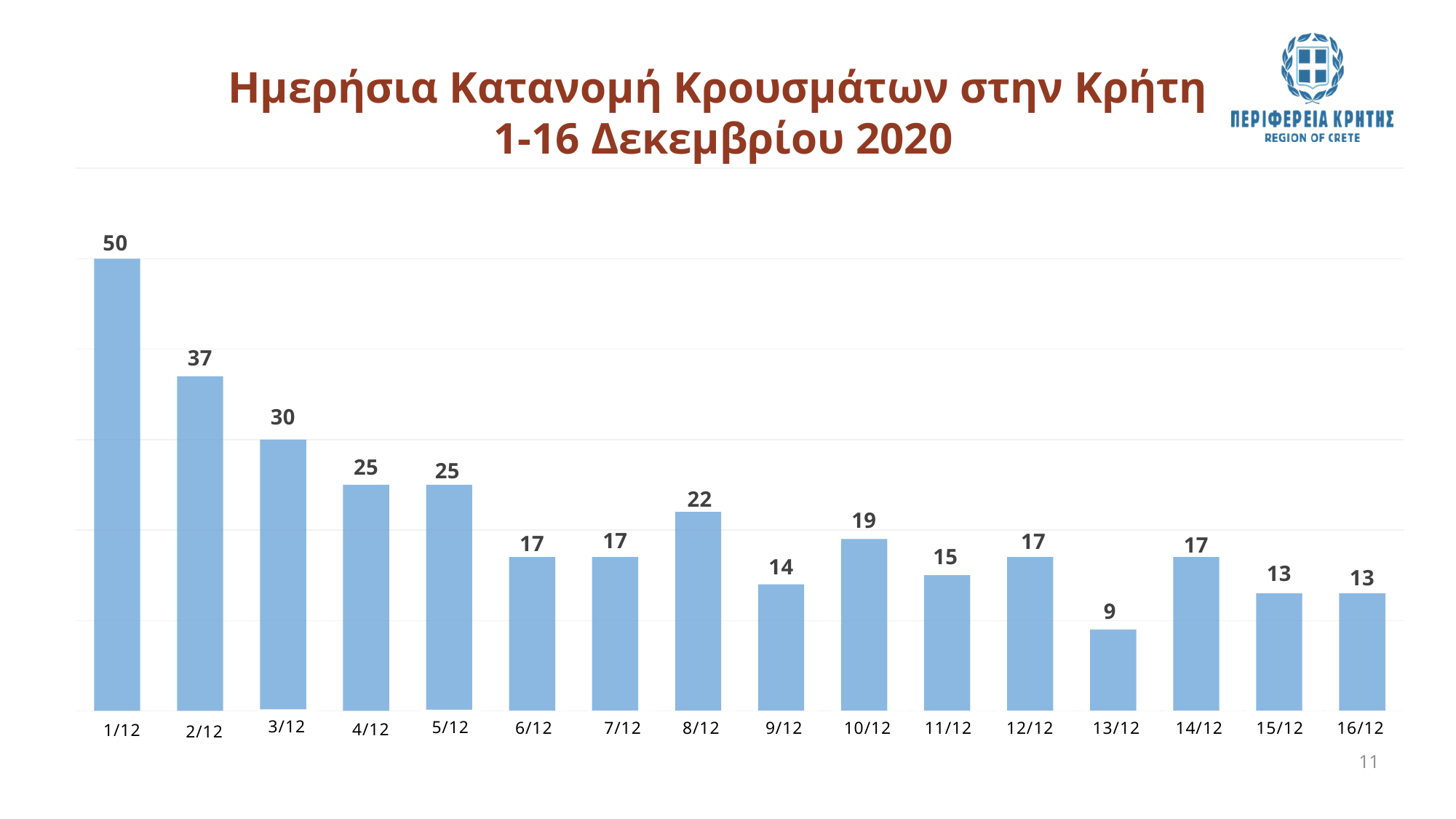
Which date has the lowest value? 13/12 What is the difference between the values for 1/12 and 2/12? 13 Which date has the highest value? 1/12 What is the difference between the values for 10/12 and 9/12? 5 How many dates are shown on the x axis? 16 What is the value for 8/12? 22 What is the value for 1/12? 50 Which is larger, the value for 3/12 or the value for 4/12? 3/12 What kind of chart is this? bar chart What is the title of the chart? Ημερήσια Κατανομή Κρουσμάτων στην Κρήτη 1-16 Δεκεμβρίου 2020 What is the value for 13/12? 9 Do the values generally rise or fall from 1/12 to 16/12? fall